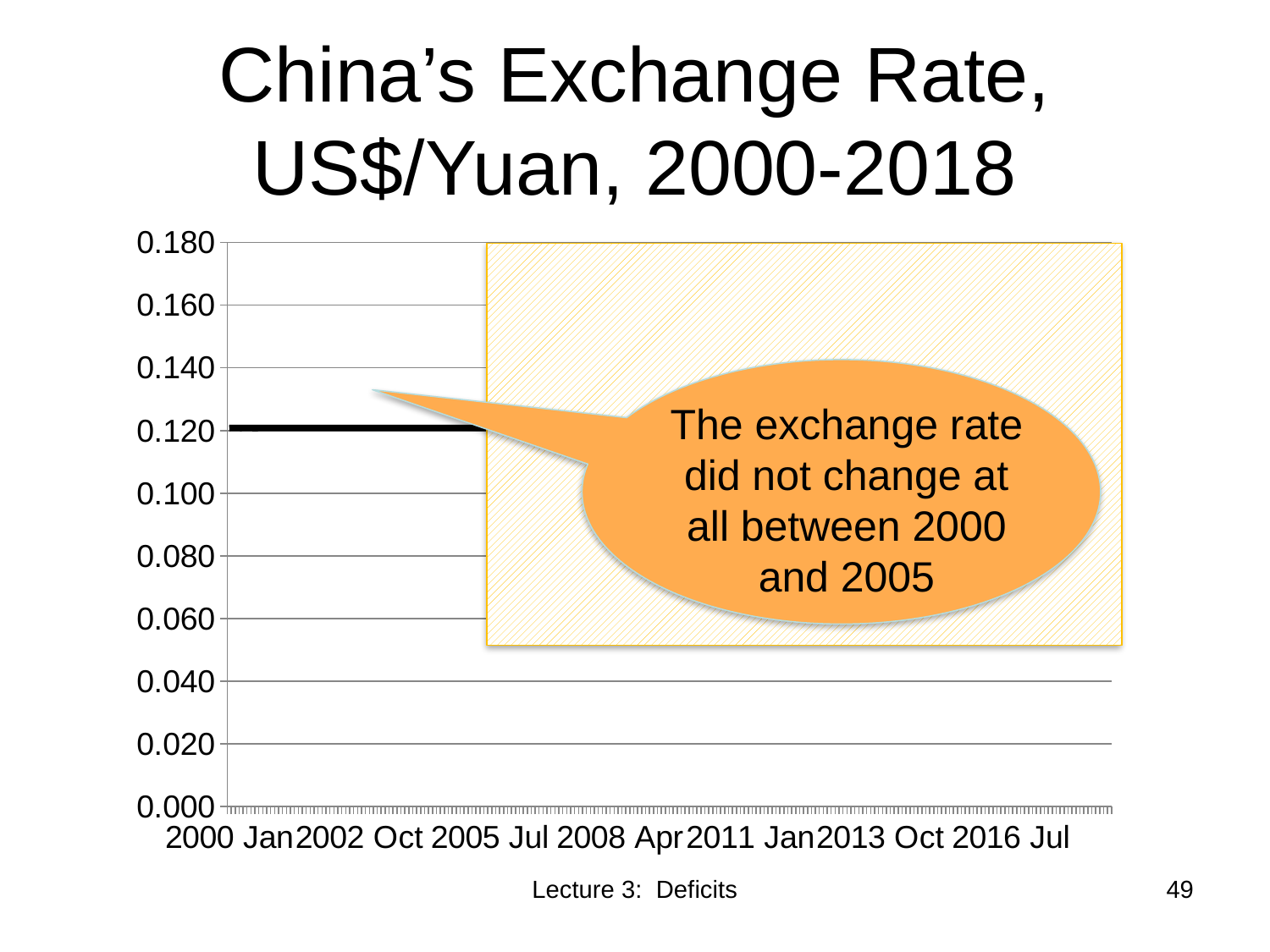
Is the exchange rate in 2002 greater or less than 0.100? greater Is the exchange rate in 2000 greater or less than 0.140? less How does the exchange rate change between 2000 and 2005 according to the chart? It stays flat (does not change) What is the title of the chart? China's Exchange Rate, US$/Yuan, 2000-2018 What kind of chart is shown on the slide? Line chart What is the last date label on the horizontal axis? 2016 Jul What is the first date label on the horizontal axis? 2000 Jan How many date labels are shown along the horizontal axis? 7 What is the highest value shown on the vertical axis? 0.180